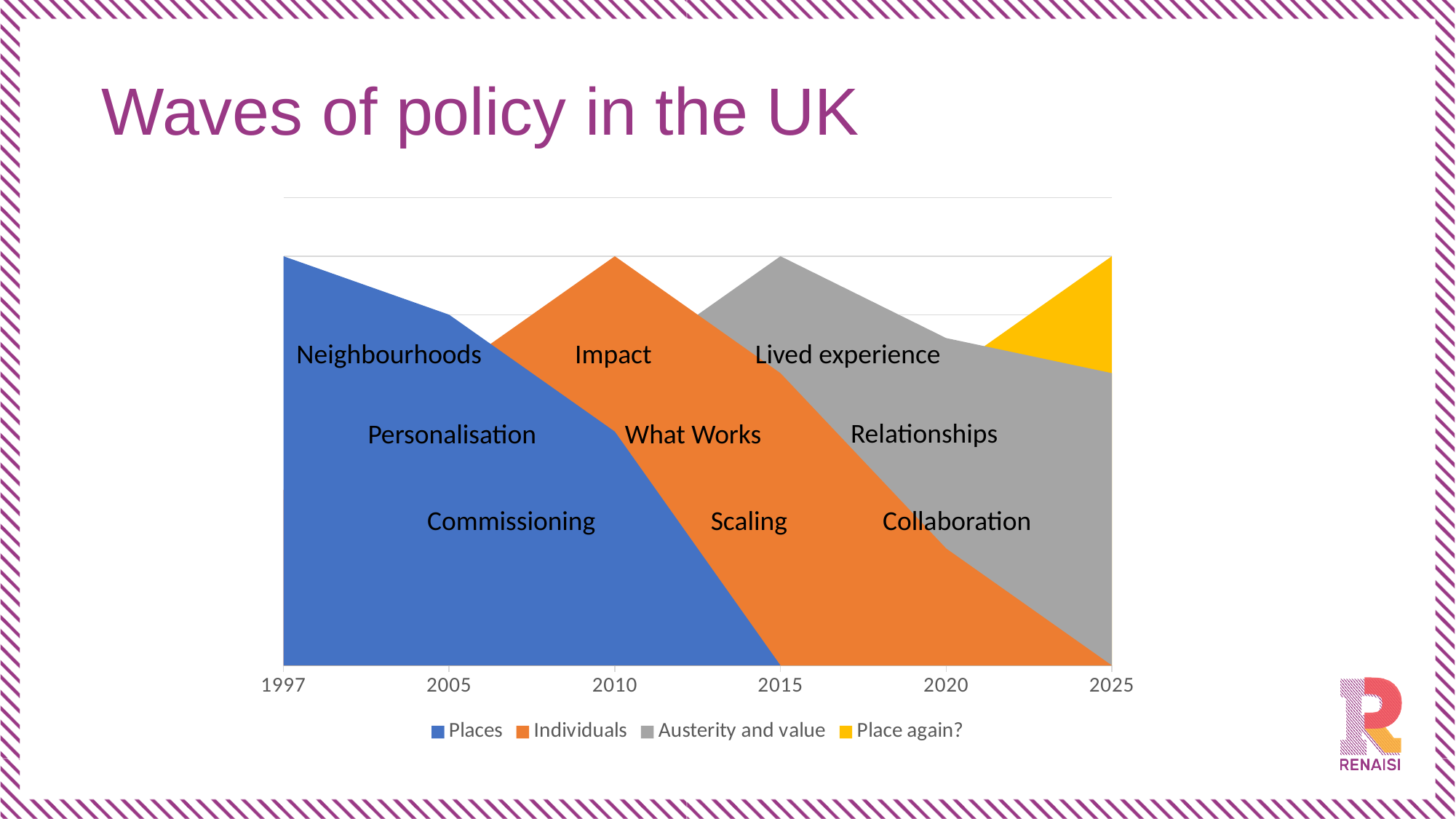
Which series has the largest value in 2015? Austerity and value Which series has the largest value in 2025? Place again? Does the Place again? series rise or fall from 2020 to 2025? Rise Which series is shown in yellow in the legend? Place again? How many years are labelled on the x axis? 6 Does the Places series rise or fall from 1997 to 2015? Fall What kind of chart is shown on the slide? Area chart In which year does the Individuals series reach its peak? 2010 What is the title of the chart on the slide? Waves of policy in the UK How many series does the legend list? 4